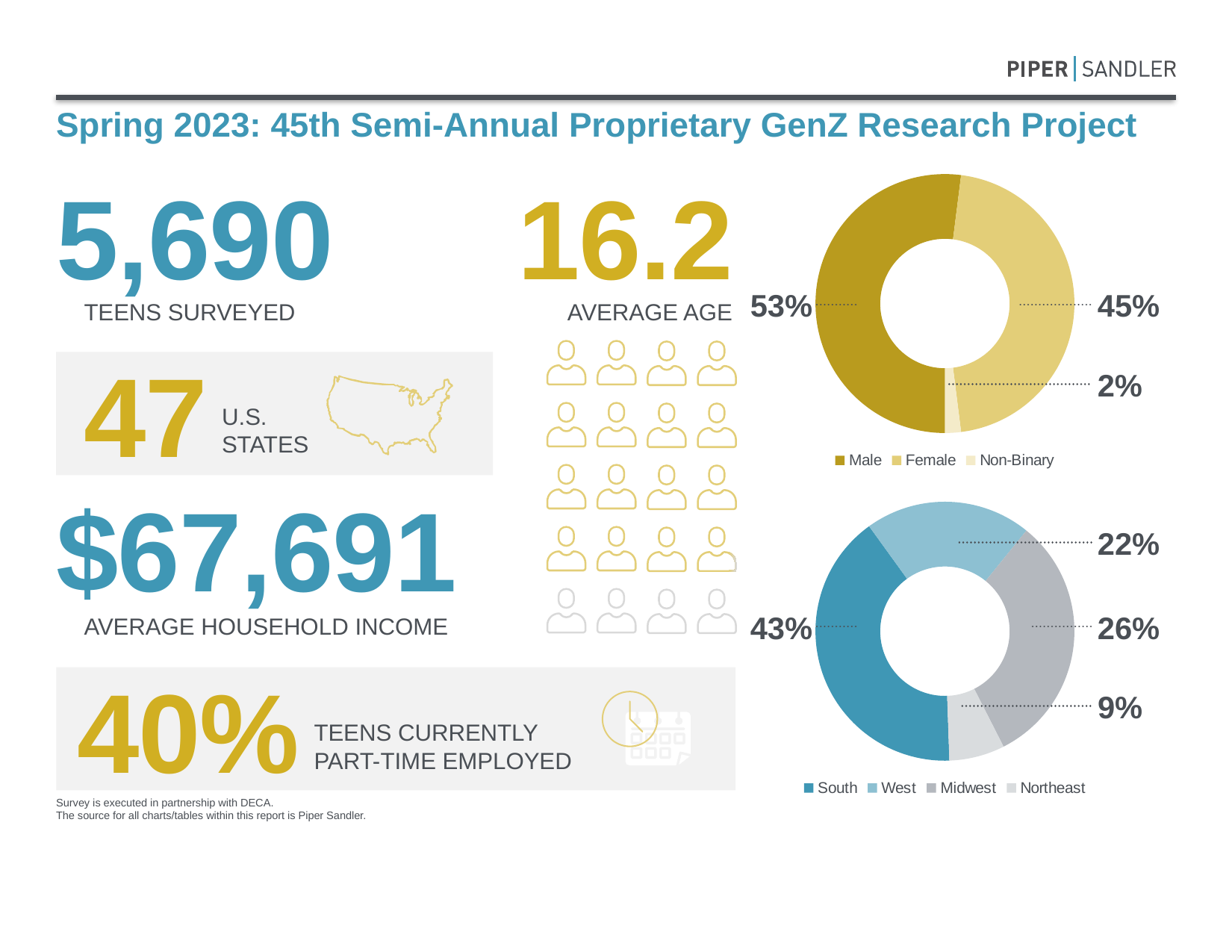
In the upper-right donut chart showing gender, what is the difference between the Male and Female shares? 8% How many regions does the legend of the lower-right donut chart list? 4 In the lower-right donut chart showing region, which is larger, West or Midwest? Midwest In the lower-right donut chart showing region, which region has the smallest share? Northeast In the lower-right donut chart showing region, what share is South? 43% In the upper-right donut chart showing gender, what share is Female? 45% In the upper-right donut chart showing gender, which category has the smallest share? Non-Binary How many categories does the legend of the upper-right gender donut chart list? 3 In the lower-right donut chart showing region, which region has the largest share? South In the upper-right donut chart showing gender, what share is Male? 53% In the lower-right donut chart showing region, what share is Midwest? 26% What type of chart is the upper-right chart showing gender? Donut (pie) chart